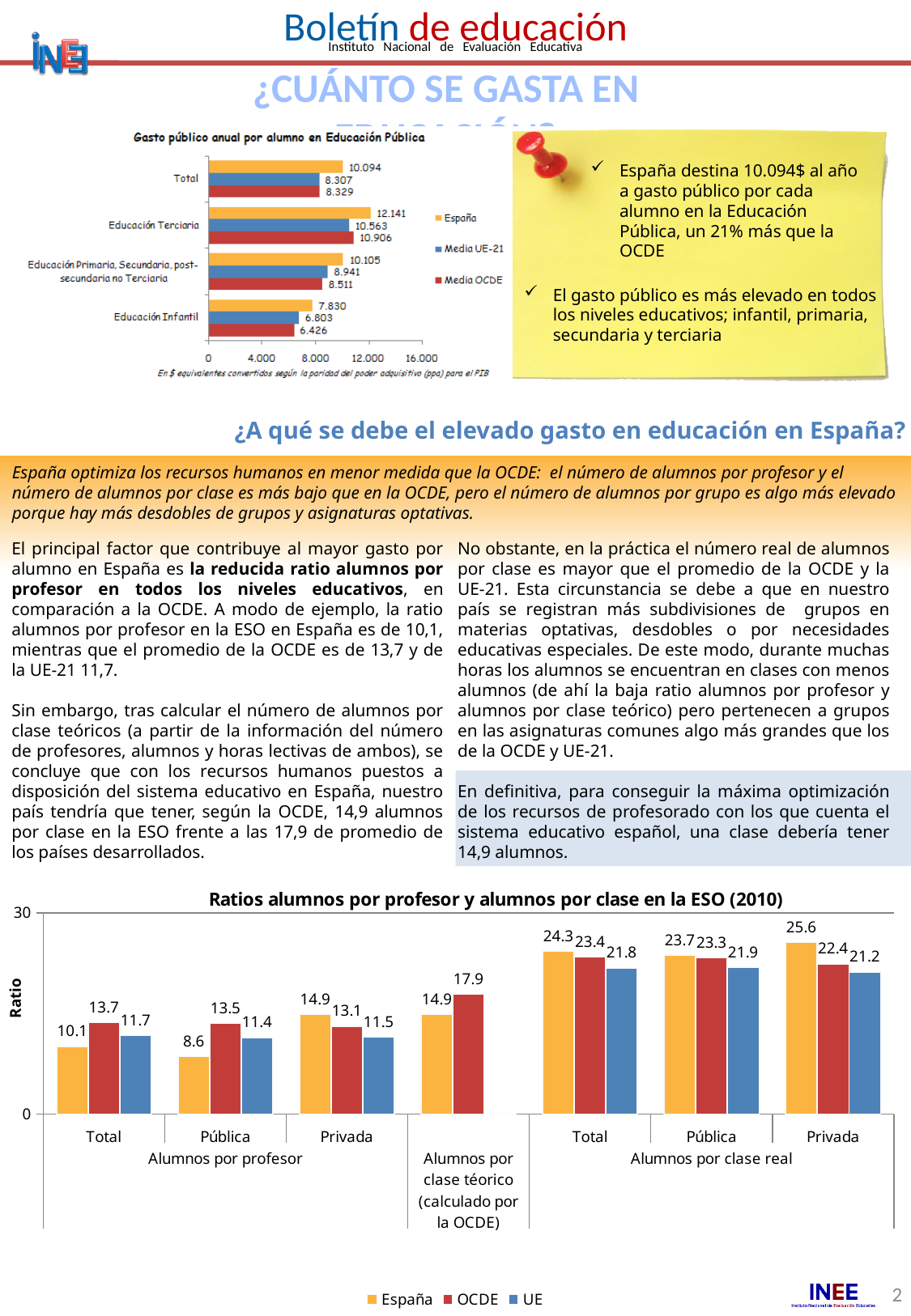
In the chart 'Gasto público anual por alumno en Educación Pública', which education level has the highest value for España? Educación Terciaria In the chart 'Gasto público anual por alumno en Educación Pública', what is the Media OCDE value for Educación Infantil? 6.426 In the chart 'Ratios alumnos por profesor y alumnos por clase en la ESO (2010)', what is the OCDE value for Alumnos por clase teórico (calculado por la OCDE)? 17.9 In the chart 'Gasto público anual por alumno en Educación Pública', what is the difference between España and Media OCDE for Total? 1.765 In the chart 'Ratios alumnos por profesor y alumnos por clase en la ESO (2010)', which category has the highest España value? Alumnos por clase real, Privada In the chart 'Gasto público anual por alumno en Educación Pública', how many series does the legend list? 3 In the chart 'Ratios alumnos por profesor y alumnos por clase en la ESO (2010)', which series is shown in yellow/orange? España In the chart 'Gasto público anual por alumno en Educación Pública', what is the value for España in Educación Terciaria? 12.141 In the chart 'Ratios alumnos por profesor y alumnos por clase en la ESO (2010)', what is the España value for Alumnos por profesor, Pública? 8.6 In the chart 'Gasto público anual por alumno en Educación Pública', which is larger for Educación Terciaria: Media UE-21 or Media OCDE? Media OCDE In the chart 'Ratios alumnos por profesor y alumnos por clase en la ESO (2010)', what is the difference between the España and UE values for Alumnos por clase real, Total? 2.5 What type of chart is 'Gasto público anual por alumno en Educación Pública'? Bar chart